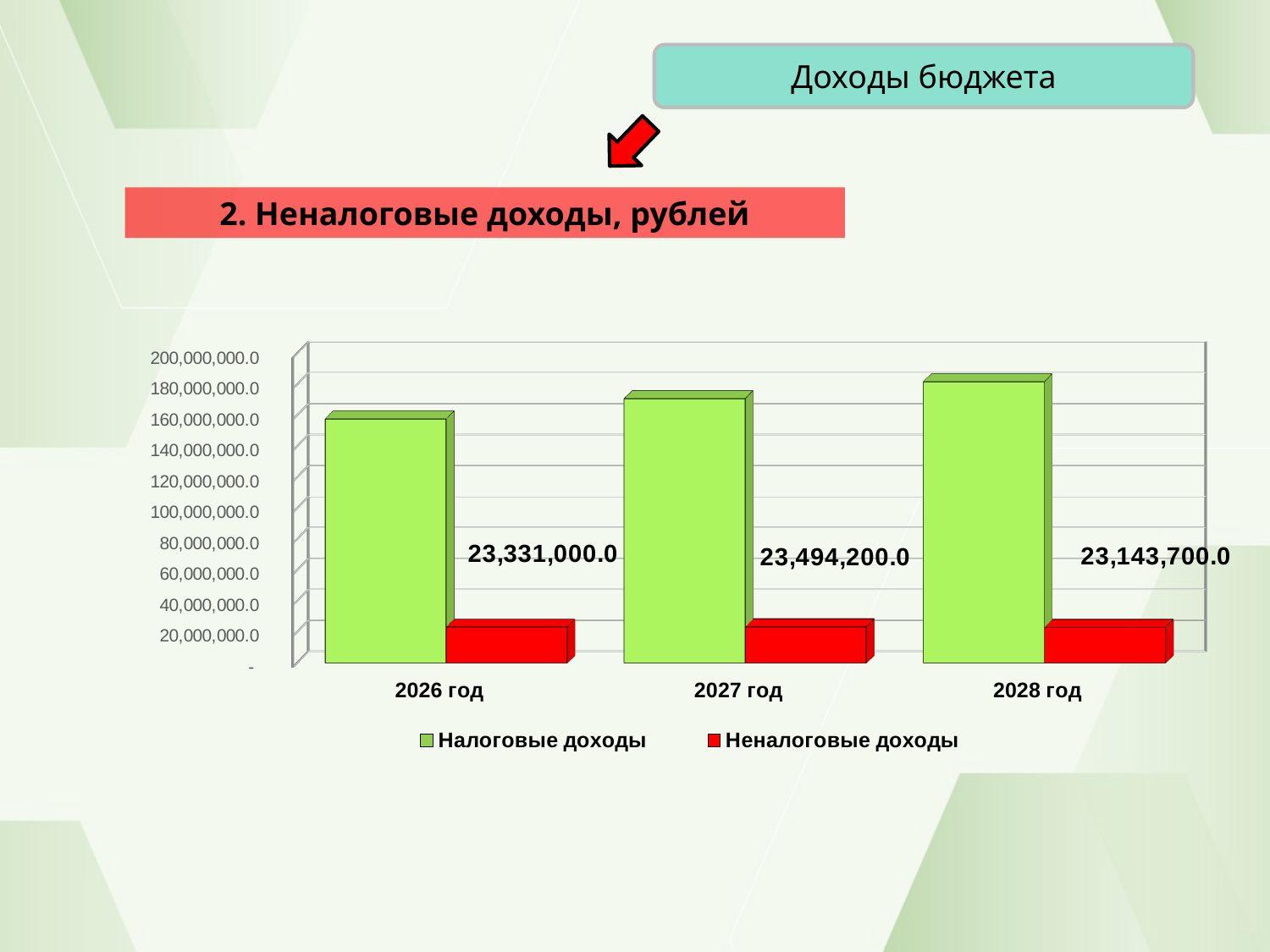
Is the value of Налоговые доходы for 2028 год greater or less than 160,000,000.0? greater In which year is Неналоговые доходы lowest? 2028 год What is the value of Неналоговые доходы for 2028 год? 23,143,700.0 How many years are shown on the x axis? 3 Which is larger: Неналоговые доходы in 2026 год or in 2028 год? 2026 год What is the value of Неналоговые доходы for 2027 год? 23,494,200.0 What is the difference between Неналоговые доходы in 2027 год and 2026 год? 163,200.0 What is the difference between Неналоговые доходы in 2026 год and 2028 год? 187,300.0 Is the value of Налоговые доходы for 2026 год greater or less than 180,000,000.0? less What is the value of Неналоговые доходы for 2026 год? 23,331,000.0 In which year is Неналоговые доходы highest? 2027 год How many series does the legend list? 2